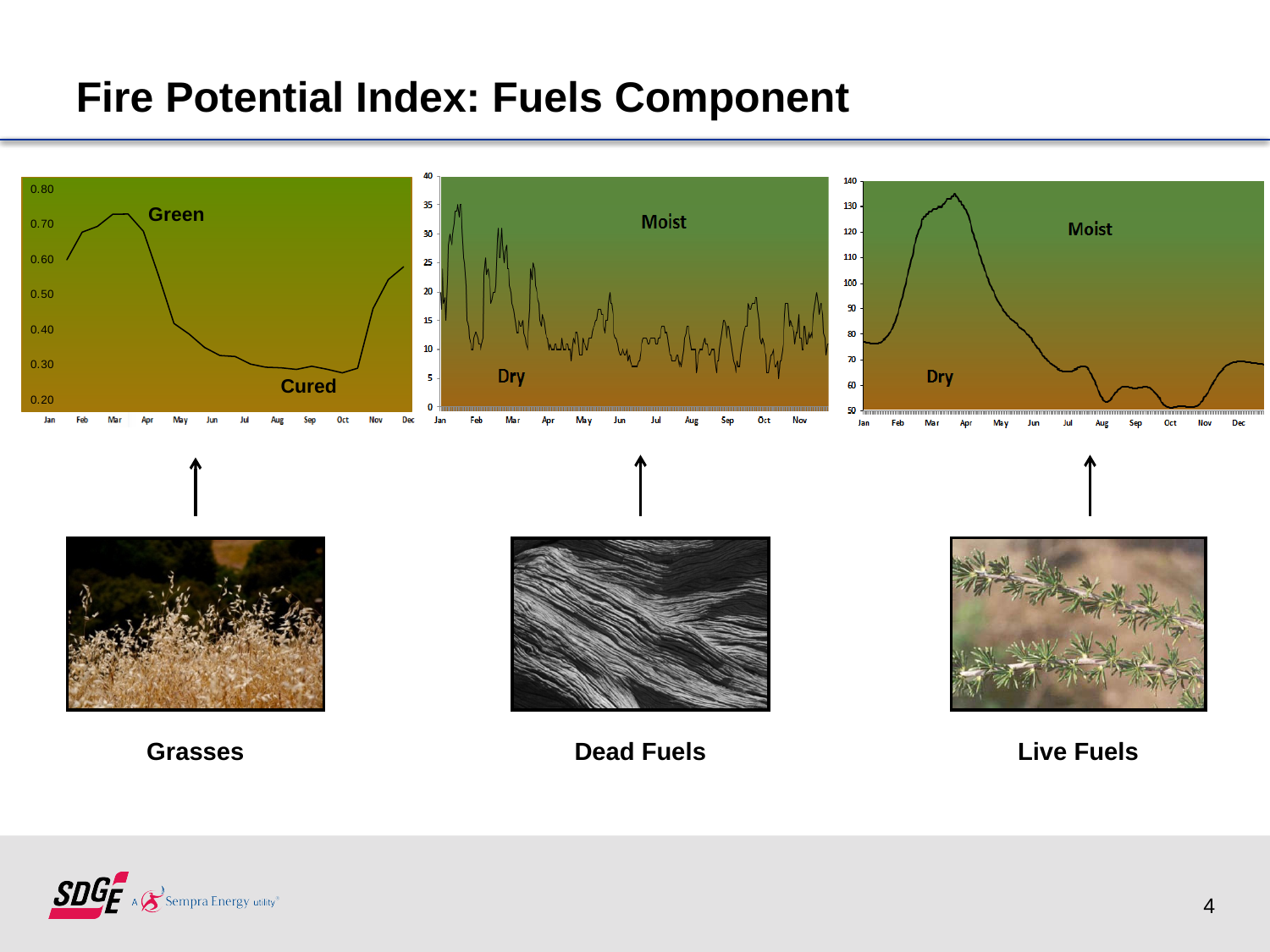
On the Grasses chart (left), what two condition labels are written on the chart? Green and Cured What kind of chart is the Live Fuels chart on the right of the slide? line chart On the Grasses chart (left), is the value for Oct greater or less than 0.40? less On the Grasses chart (left), how many months are labelled on the x axis? 12 On the Grasses chart (left), do the values rise or fall from Apr to Oct? fall What kind of chart is the Grasses chart on the left of the slide? line chart On the Dead Fuels chart (middle), is the peak value in Feb greater or less than 30? greater On the Live Fuels chart (right), is the value for Apr greater or less than 120? greater On the Live Fuels chart (right), in which month does the line reach its highest value? Apr